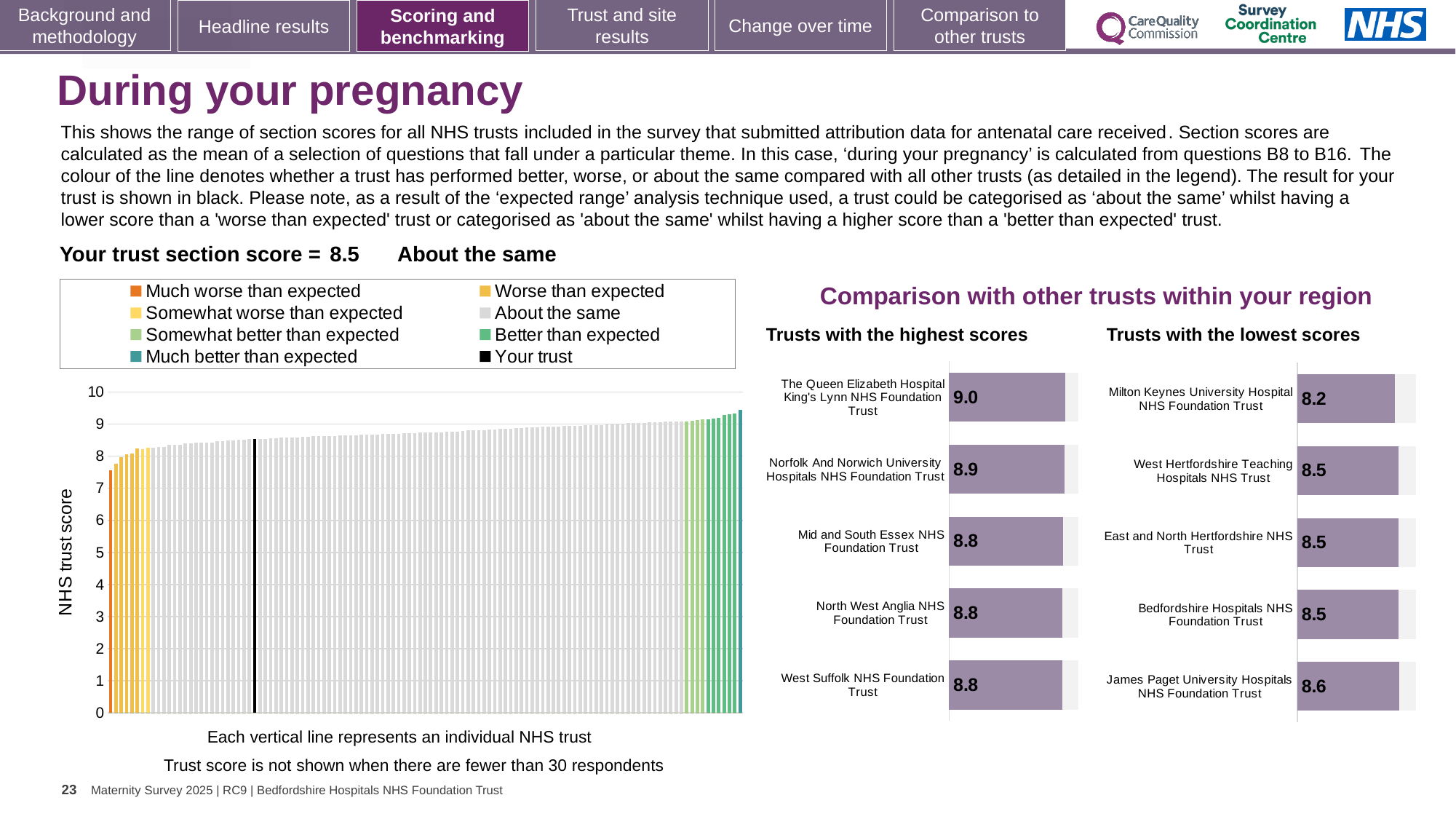
In the 'Trusts with the highest scores' chart, what is the score for The Queen Elizabeth Hospital King's Lynn NHS Foundation Trust? 9.0 How many trusts are shown in the 'Trusts with the highest scores' chart? 5 In the NHS trust score chart on the left, do the trust scores rise or fall from left to right? rise In the 'Trusts with the lowest scores' chart, which trust has the lowest score? Milton Keynes University Hospital NHS Foundation Trust In the 'Trusts with the lowest scores' chart, what is the score for James Paget University Hospitals NHS Foundation Trust? 8.6 How many entries does the legend of the NHS trust score chart on the left list? 8 In the 'Trusts with the lowest scores' chart, what is the difference between the scores of James Paget University Hospitals NHS Foundation Trust and Milton Keynes University Hospital NHS Foundation Trust? 0.4 In the 'Trusts with the highest scores' chart, what is the difference between the scores of The Queen Elizabeth Hospital King's Lynn NHS Foundation Trust and West Suffolk NHS Foundation Trust? 0.2 In the 'Trusts with the lowest scores' chart, what is the score for Milton Keynes University Hospital NHS Foundation Trust? 8.2 In the 'Trusts with the lowest scores' chart, which has the larger score: James Paget University Hospitals NHS Foundation Trust or Milton Keynes University Hospital NHS Foundation Trust? James Paget University Hospitals NHS Foundation Trust In the 'Trusts with the highest scores' chart, what is the score for Norfolk And Norwich University Hospitals NHS Foundation Trust? 8.9 In the 'Trusts with the highest scores' chart, which trust has the highest score? The Queen Elizabeth Hospital King's Lynn NHS Foundation Trust